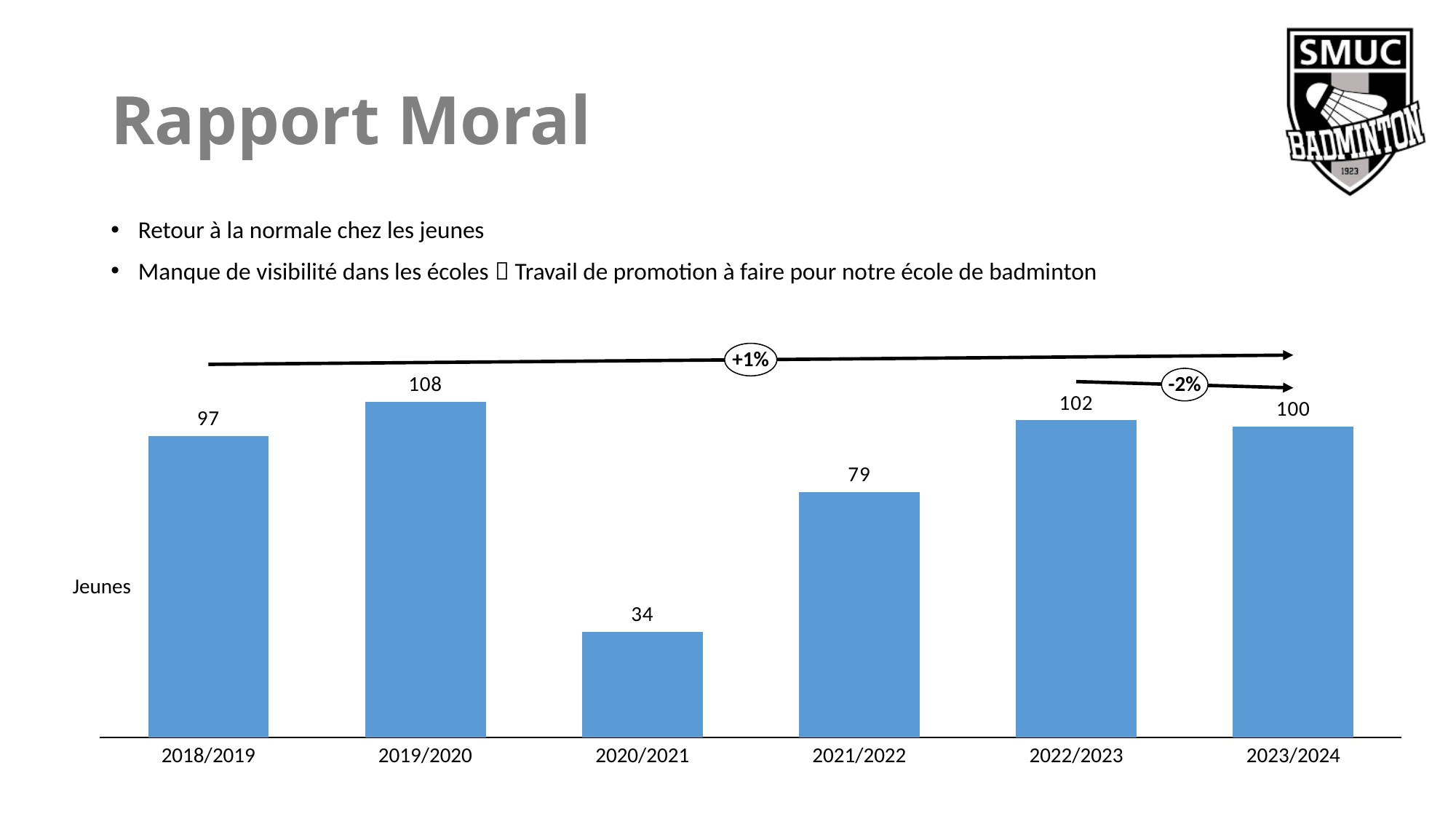
What kind of chart is shown on the slide? bar chart Which season has the highest value? 2019/2020 What is the difference between the values for 2019/2020 and 2020/2021? 74 Which is larger, the value for 2021/2022 or the value for 2018/2019? 2018/2019 What is the value for 2020/2021? 34 Does the value rise or fall from 2020/2021 to 2022/2023? rise Which season has the lowest value? 2020/2021 How many seasons are shown on the x axis? 6 What is the value for 2023/2024? 100 What is the difference between the values for 2022/2023 and 2023/2024? 2 What label is written to the left of the bars? Jeunes What is the value for 2018/2019? 97